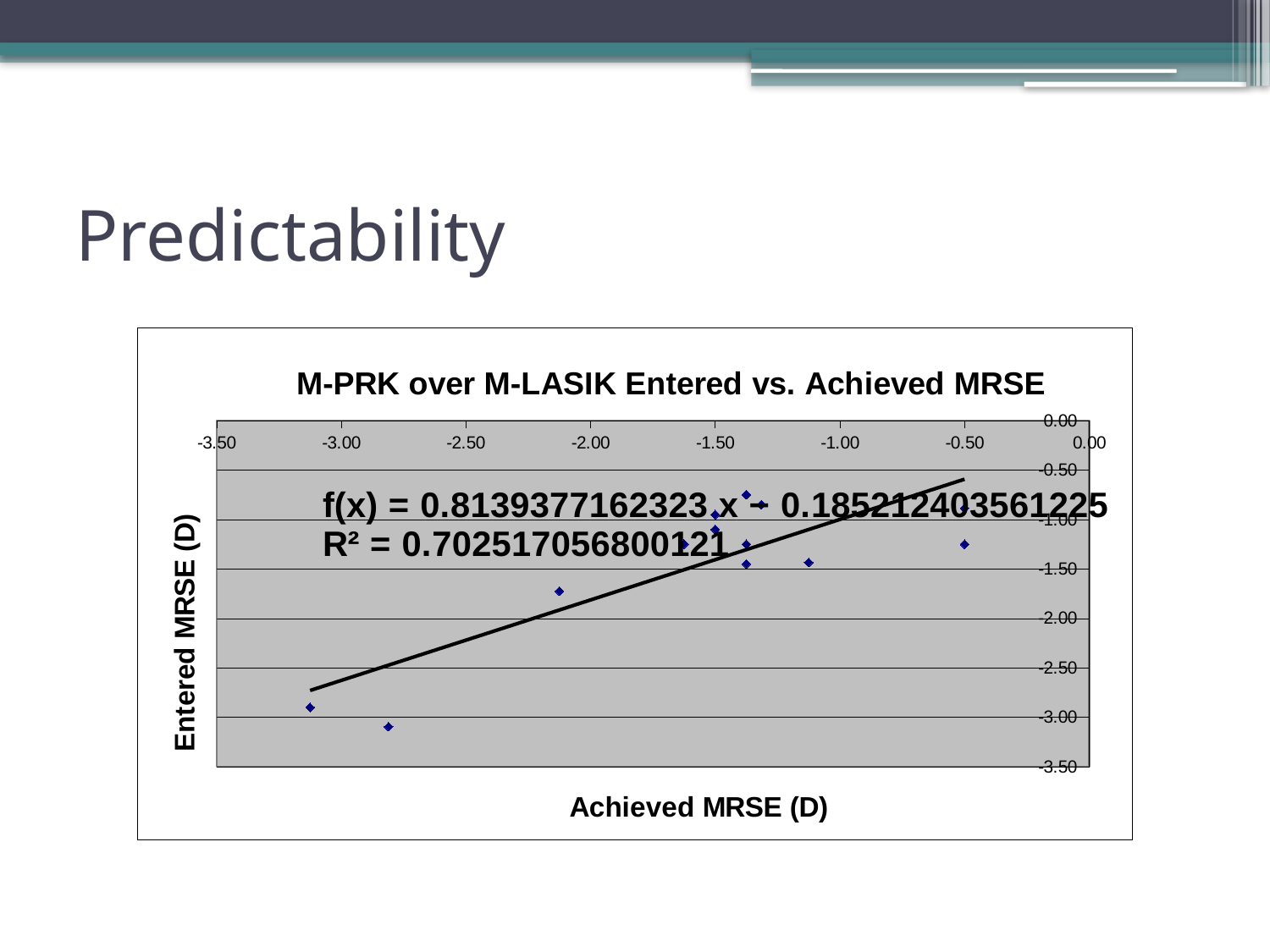
Is the Entered MRSE of the point at about -2.10 Achieved MRSE greater or less than -2.00? greater What is the label of the horizontal axis? Achieved MRSE (D) What is the lowest value shown on the vertical axis? -3.50 What is the title of the chart? M-PRK over M-LASIK Entered vs. Achieved MRSE What is the slope of the trendline equation printed on the chart? 0.8139377162323 What is the leftmost value shown on the horizontal axis? -3.50 What kind of chart is shown on the slide? Scatter chart What is the intercept in the trendline equation f(x) printed on the chart? -0.185212403561225 Do the plotted Entered MRSE values rise or fall as Achieved MRSE increases from -3.50 toward 0.00? Rise Is the Entered MRSE of the point at about -2.80 Achieved MRSE greater or less than -3.00? less What R² value is printed on the chart? 0.702517056800121